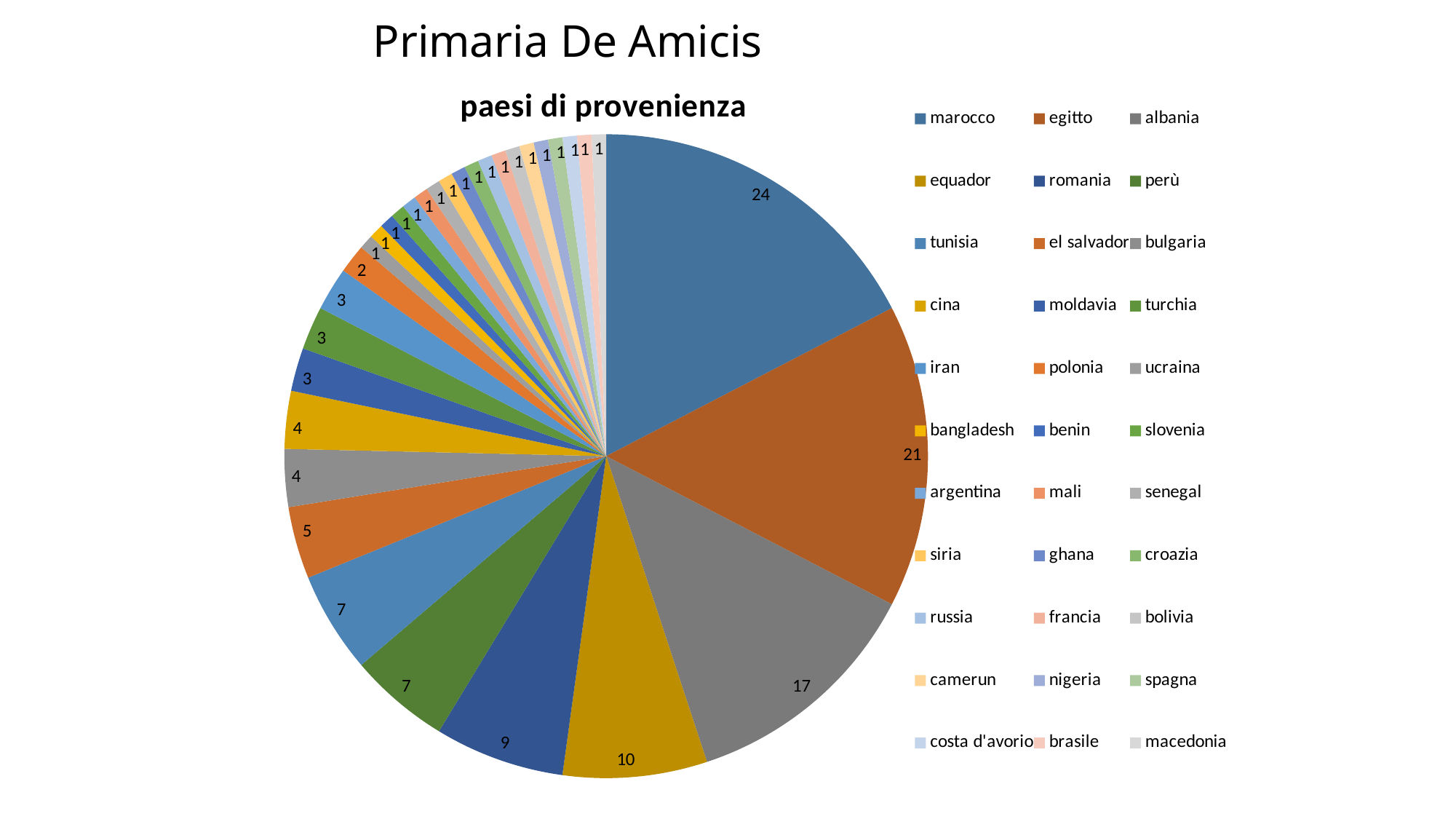
What is the value for equador in the pie chart? 10 What kind of chart is shown on the slide? pie chart What is the difference between the values for marocco and egitto? 3 What is the value for el salvador in the pie chart? 5 What is the value for egitto in the pie chart? 21 What is the value for albania in the pie chart? 17 What is the title of the chart? paesi di provenienza What is the value for romania in the pie chart? 9 Which has a larger value, albania or equador? albania What is the value for marocco in the pie chart? 24 What is the value for polonia in the pie chart? 2 Which country has the largest slice in the pie chart? marocco